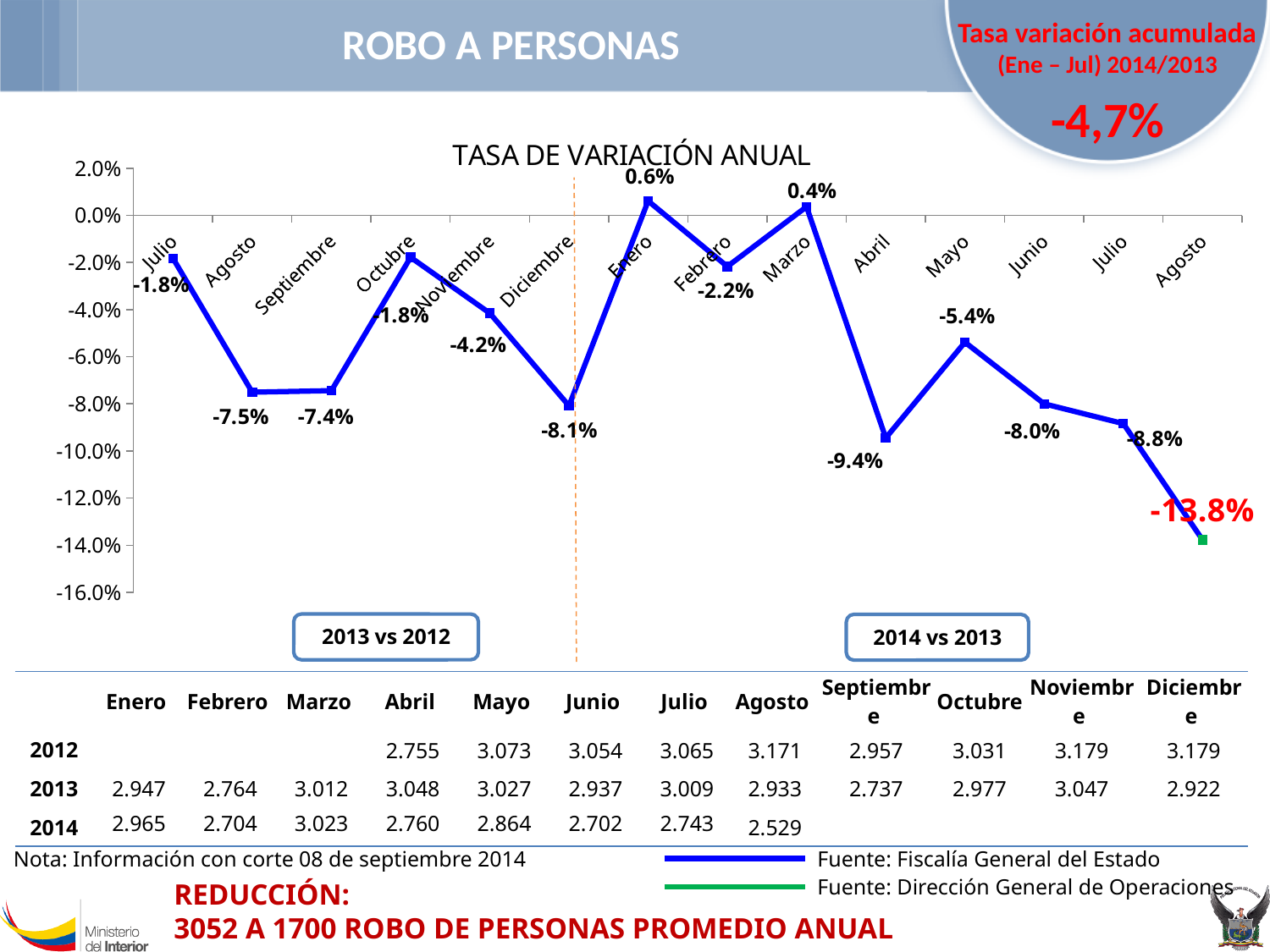
What type of chart is 'TASA DE VARIACIÓN ANUAL'? line chart In the 'TASA DE VARIACIÓN ANUAL' chart, what is the value for Diciembre? -8.1% How many data points are plotted in the 'TASA DE VARIACIÓN ANUAL' chart? 14 In the 'TASA DE VARIACIÓN ANUAL' chart, what is the value for Enero? 0.6% What is the title of the line chart on the slide? TASA DE VARIACIÓN ANUAL In the 'TASA DE VARIACIÓN ANUAL' chart, which month has the lowest value? Agosto (2014 vs 2013) In the 'TASA DE VARIACIÓN ANUAL' chart, what is the value for Abril? -9.4% In the 'TASA DE VARIACIÓN ANUAL' chart, what is the difference between the values for Mayo and Abril? 4.0% In the 'TASA DE VARIACIÓN ANUAL' chart, what is the value for Agosto in the '2014 vs 2013' section (the last point)? -13.8% In the 'TASA DE VARIACIÓN ANUAL' chart, which month has the highest value? Enero In the 'TASA DE VARIACIÓN ANUAL' chart, is the value for Abril greater or less than -8.0%? less In the 'TASA DE VARIACIÓN ANUAL' chart, which is larger, the value for Febrero or the value for Marzo? Marzo